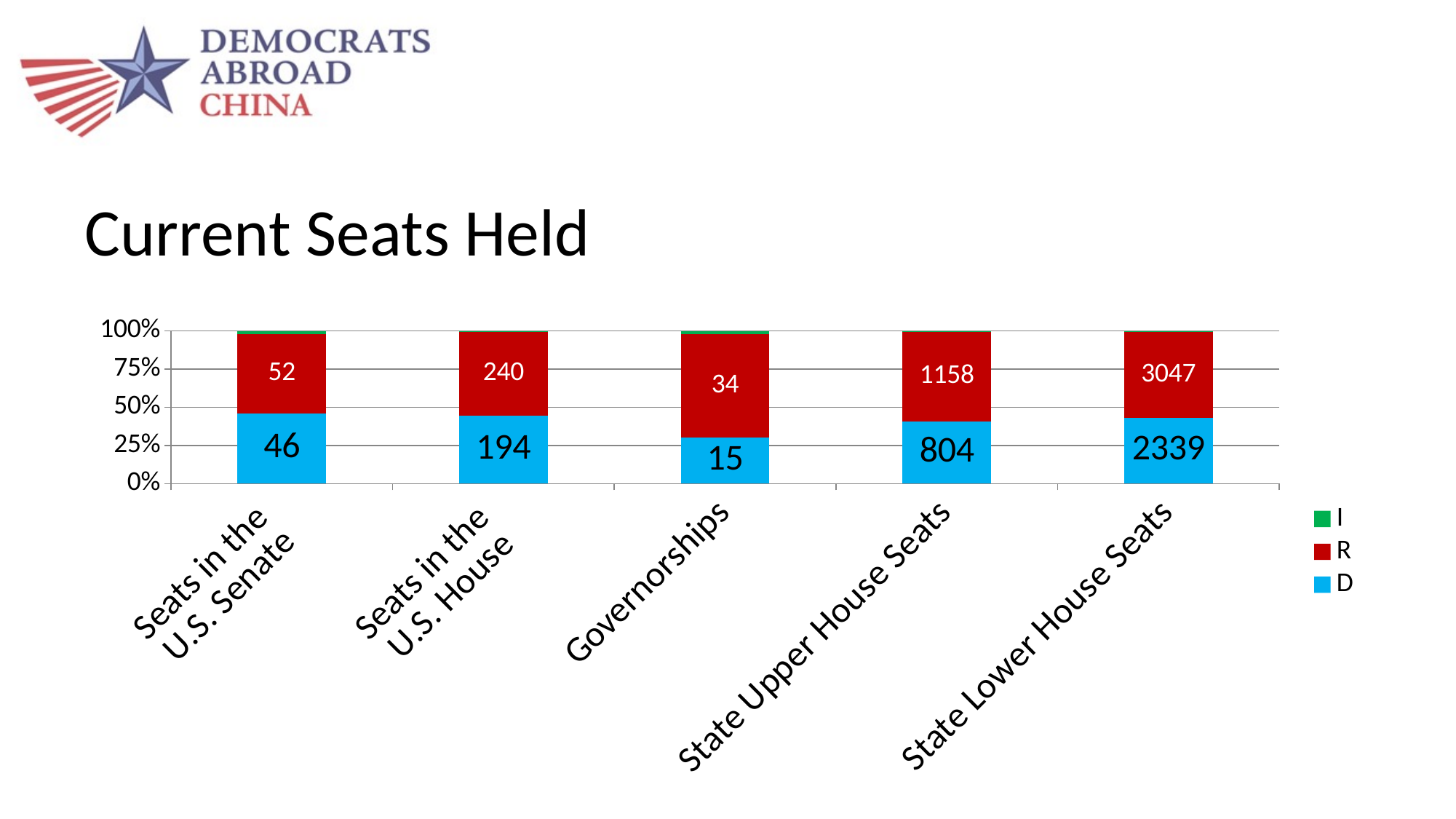
What is the difference between the R and D values for Seats in the U.S. House? 46 How many seats does D hold in the U.S. Senate according to the chart? 46 What is the difference between the R and D values for State Upper House Seats? 354 What is the R value for State Lower House Seats? 3047 What is the R value for Seats in the U.S. House? 240 How many series does the legend list? 3 How many Governorships does D hold? 15 Which category has the lowest R value? Governorships Which category has the highest D value? State Lower House Seats What kind of chart is shown on the slide? Stacked bar chart Is the D share of Governorships greater or less than 50%? less What is the D value for State Upper House Seats? 804